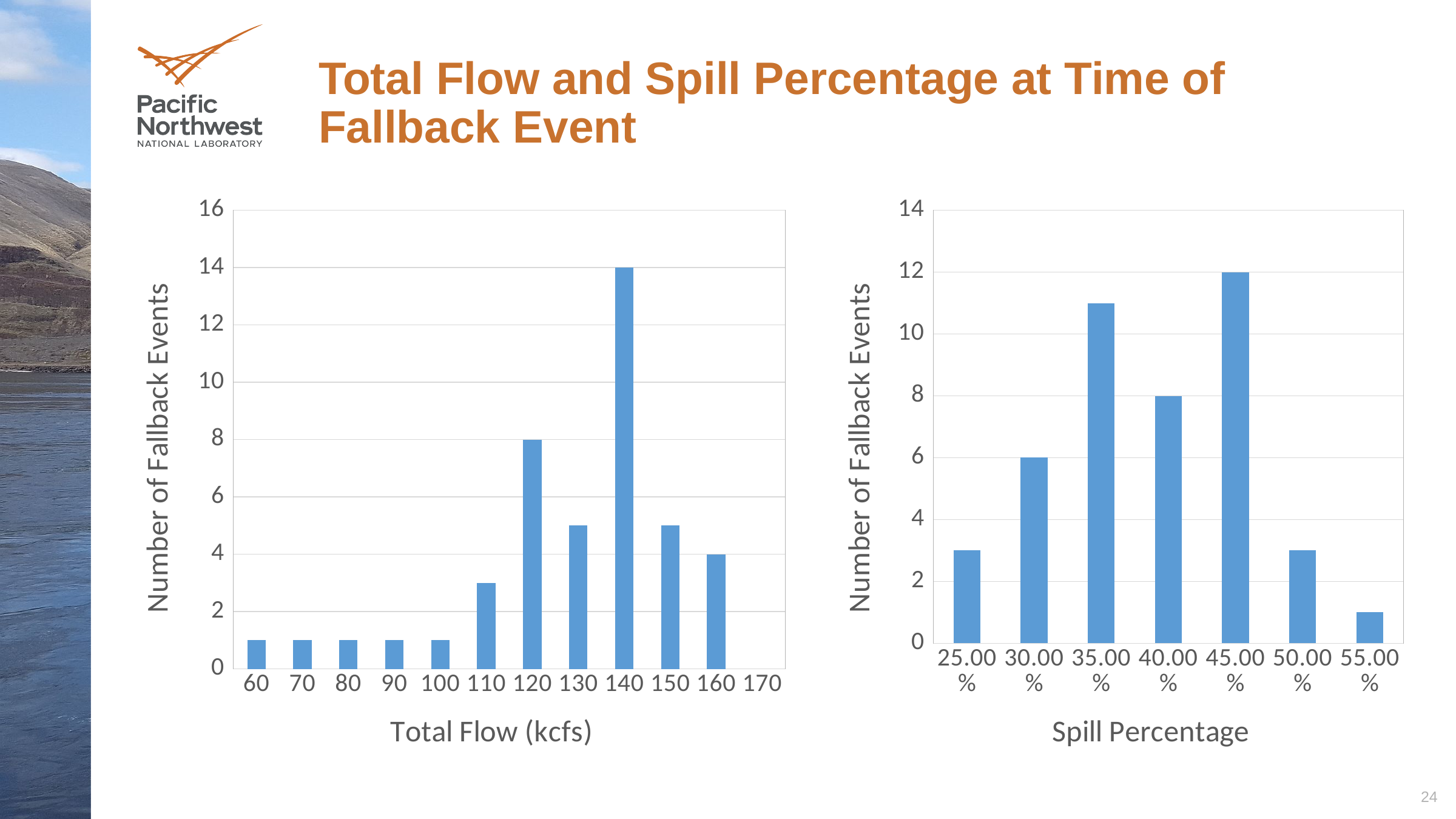
On the Total Flow (kcfs) chart, is the number of fallback events at 130 kcfs greater or less than 4? greater On the Total Flow (kcfs) chart, which total flow category has the highest number of fallback events? 140 On the Spill Percentage chart, how many fallback events occurred at 45.00% spill? 12 What type of chart is the Spill Percentage chart? bar chart On the Spill Percentage chart, is the number of fallback events at 35.00% spill greater or less than 10? greater On the Spill Percentage chart, which has more fallback events, 35.00% or 40.00% spill? 35.00% On the Total Flow (kcfs) chart, what is the difference in fallback events between the 140 kcfs and 120 kcfs categories? 6 On the Total Flow (kcfs) chart, how many fallback events occurred at a total flow of 140 kcfs? 14 On the Spill Percentage chart, how many fallback events occurred at 30.00% spill? 6 On the Total Flow (kcfs) chart, how many fallback events occurred at a total flow of 120 kcfs? 8 On the Total Flow (kcfs) chart, how many total flow categories are shown on the x axis? 12 On the Spill Percentage chart, which spill percentage category has the lowest number of fallback events? 55.00%